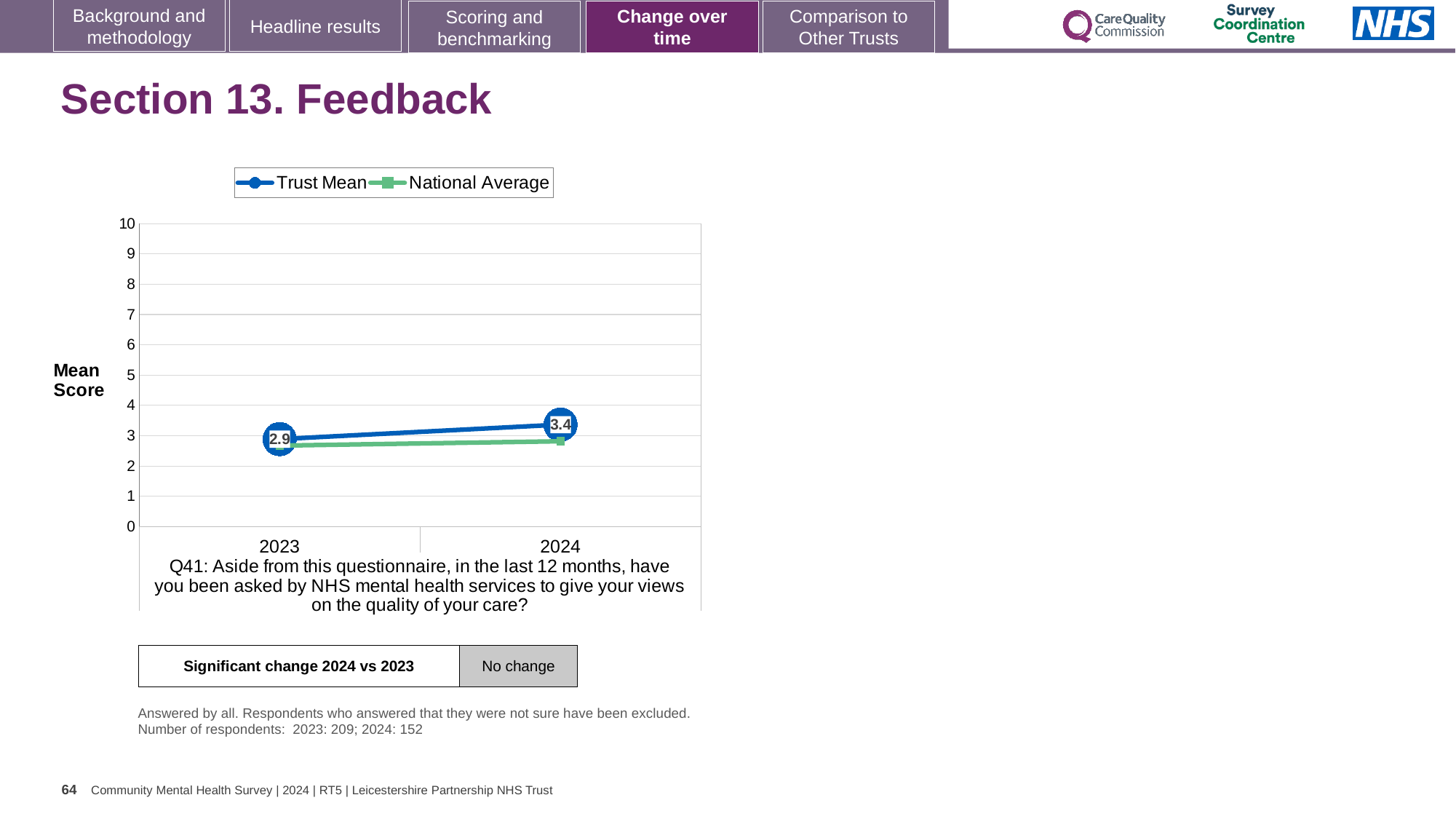
How many years are plotted on the x axis? 2 What is the Trust Mean value for 2023? 2.9 Is the National Average value for 2023 greater or less than 2? greater Does the Trust Mean rise or fall from 2023 to 2024? rise How many series does the legend list? 2 In 2024, which is larger: the Trust Mean or the National Average? Trust Mean What is the Trust Mean value for 2024? 3.4 In which year is the Trust Mean highest? 2024 In which year is the Trust Mean lowest? 2023 What kind of chart is shown on the slide? line chart What is the difference between the Trust Mean in 2024 and in 2023? 0.5 Is the National Average value for 2024 greater or less than 5? less